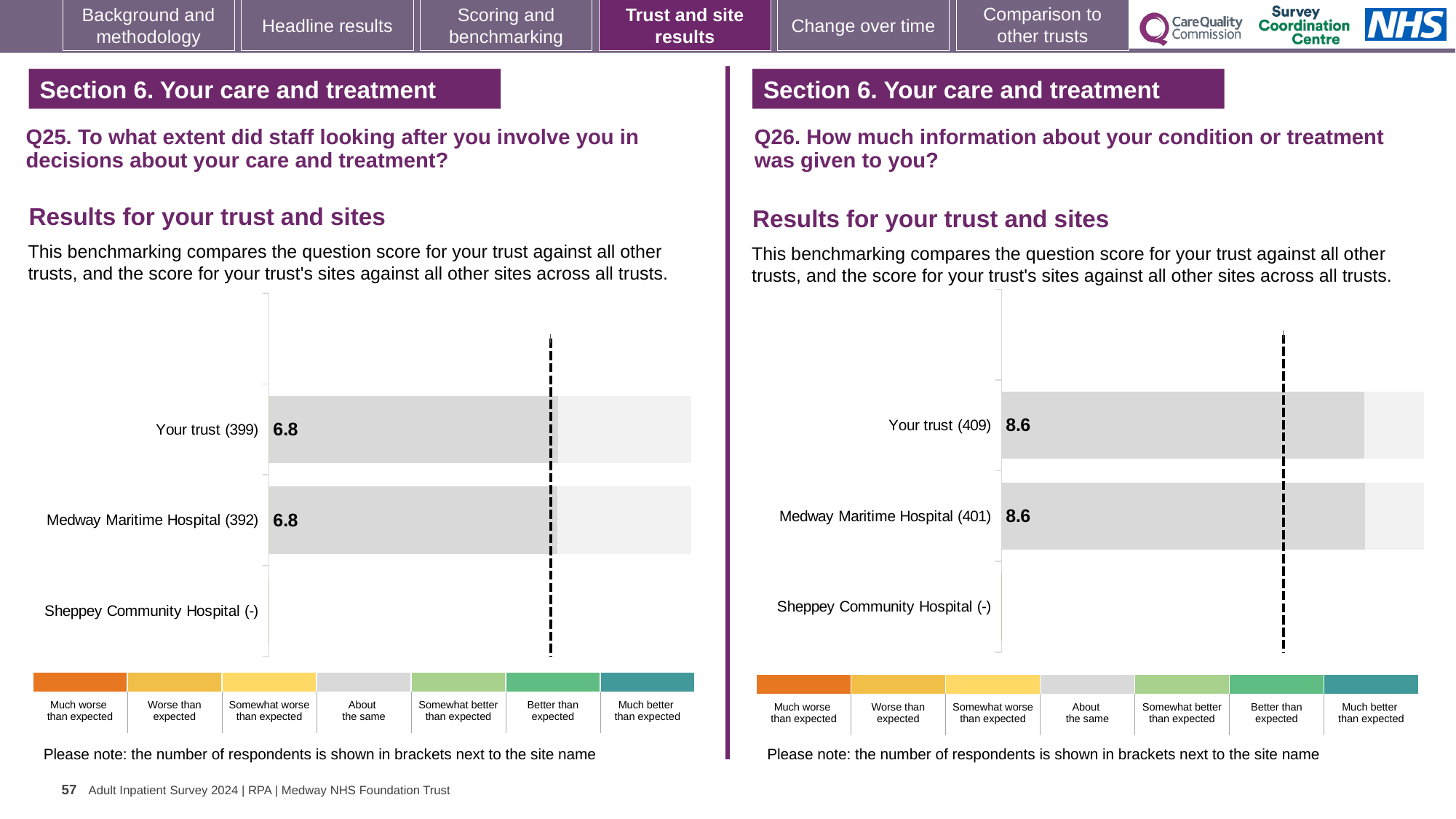
What kind of chart is used on the Q25 chart (left)? Bar chart On the Q26 chart (right), what is the score for Your trust? 8.6 On the Q26 chart (right), how many respondents are shown in brackets for Medway Maritime Hospital? 401 How many site/trust categories are listed on the Q25 chart (left)? 3 Is the score for Your trust on the Q26 chart (right) larger or smaller than the score for Your trust on the Q25 chart (left)? Larger On the Q25 chart (left), what is the score for Medway Maritime Hospital? 6.8 How many site/trust categories are listed on the Q26 chart (right)? 3 On the Q26 chart (right), what is the score for Medway Maritime Hospital? 8.6 On the Q25 chart (left), what is the score for Your trust? 6.8 On the Q25 chart (left), how many respondents are shown in brackets for Your trust? 399 On the Q26 chart (right), what is the difference between the score for Your trust and the score for Medway Maritime Hospital? 0 On the Q25 chart (left), what is the difference between the score for Your trust and the score for Medway Maritime Hospital? 0